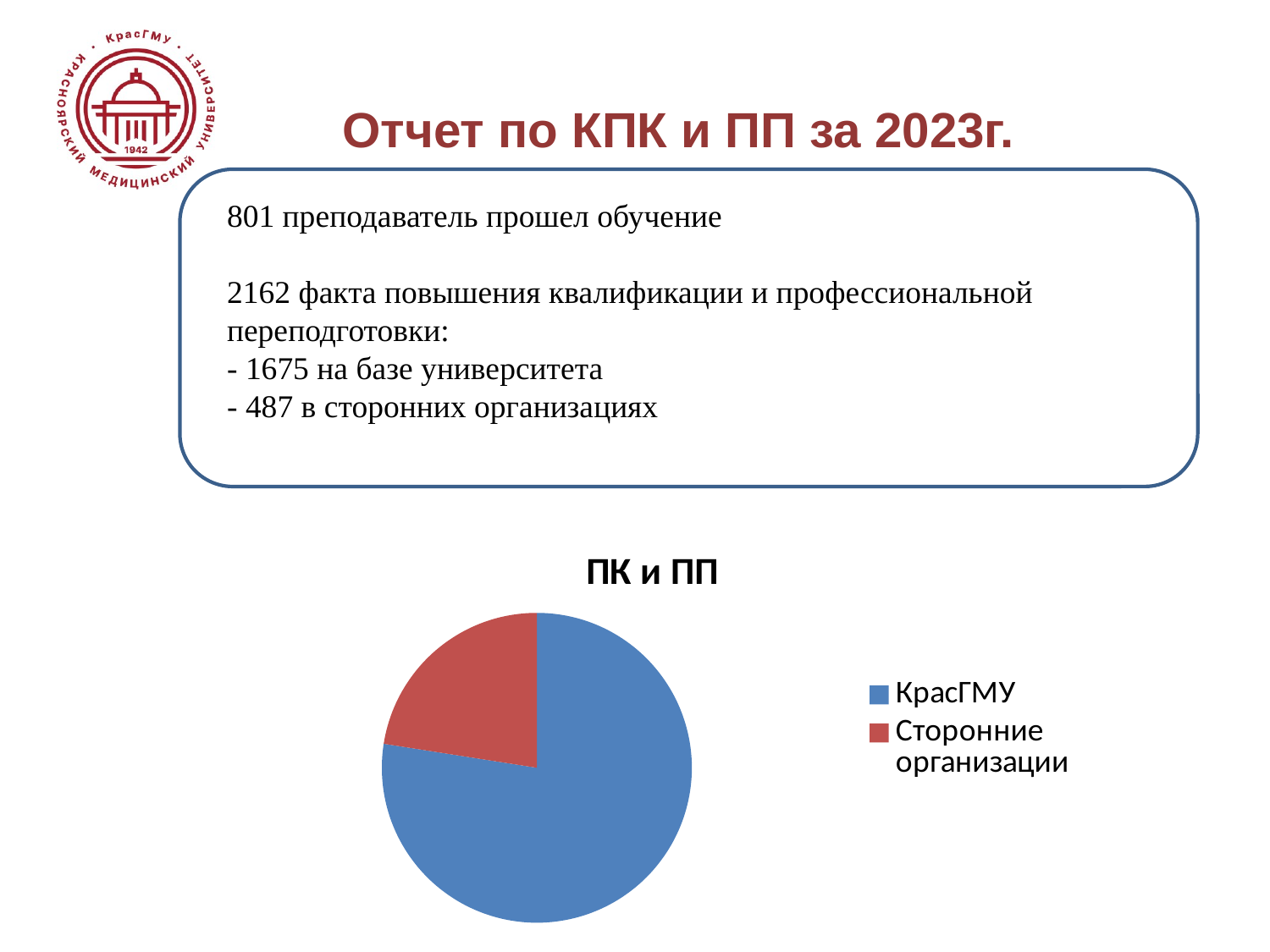
What is the title of the pie chart? ПК и ПП What colour is the slice for Сторонние организации in the pie chart? red How many entries does the legend of the pie chart list? 2 Which slice is larger in the pie chart, КрасГМУ or Сторонние организации? КрасГМУ What kind of chart is shown on the slide? pie chart Which category has the largest slice in the pie chart? КрасГМУ How many slices does the pie chart have? 2 Which category has the smallest slice in the pie chart? Сторонние организации